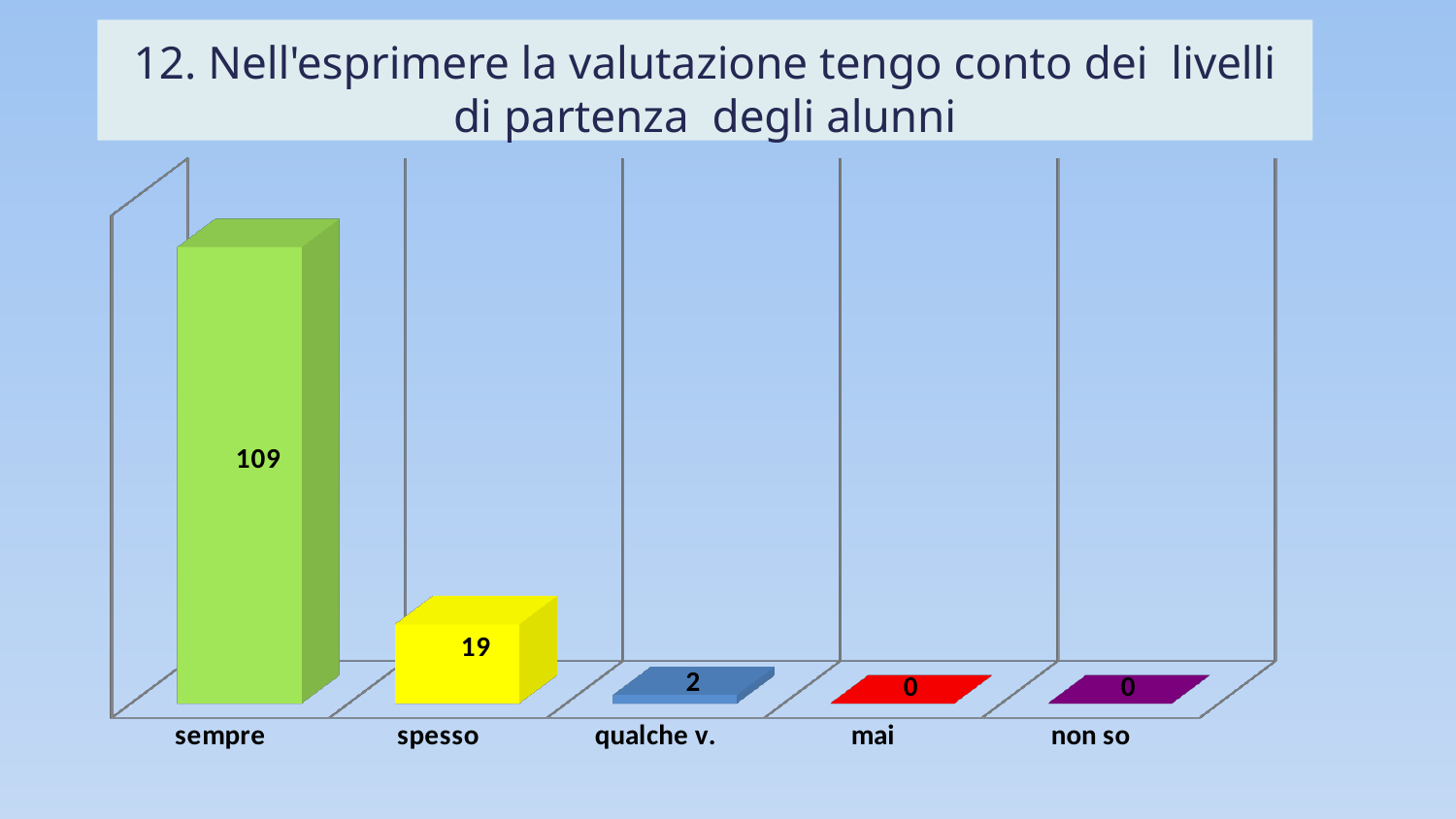
What is the value for "sempre"? 109 Which category has the highest value? sempre What is the difference between the values for "spesso" and "qualche v."? 17 What is the value for "mai"? 0 What is the difference between the values for "sempre" and "spesso"? 90 Do the values rise or fall from left to right along the x axis? fall What colour is the bar for "sempre"? green What is the value for "qualche v."? 2 What is the value for "spesso"? 19 Which is larger, the value for "spesso" or the value for "qualche v."? spesso How many categories are shown on the x axis? 5 What kind of chart is shown on the slide? bar chart